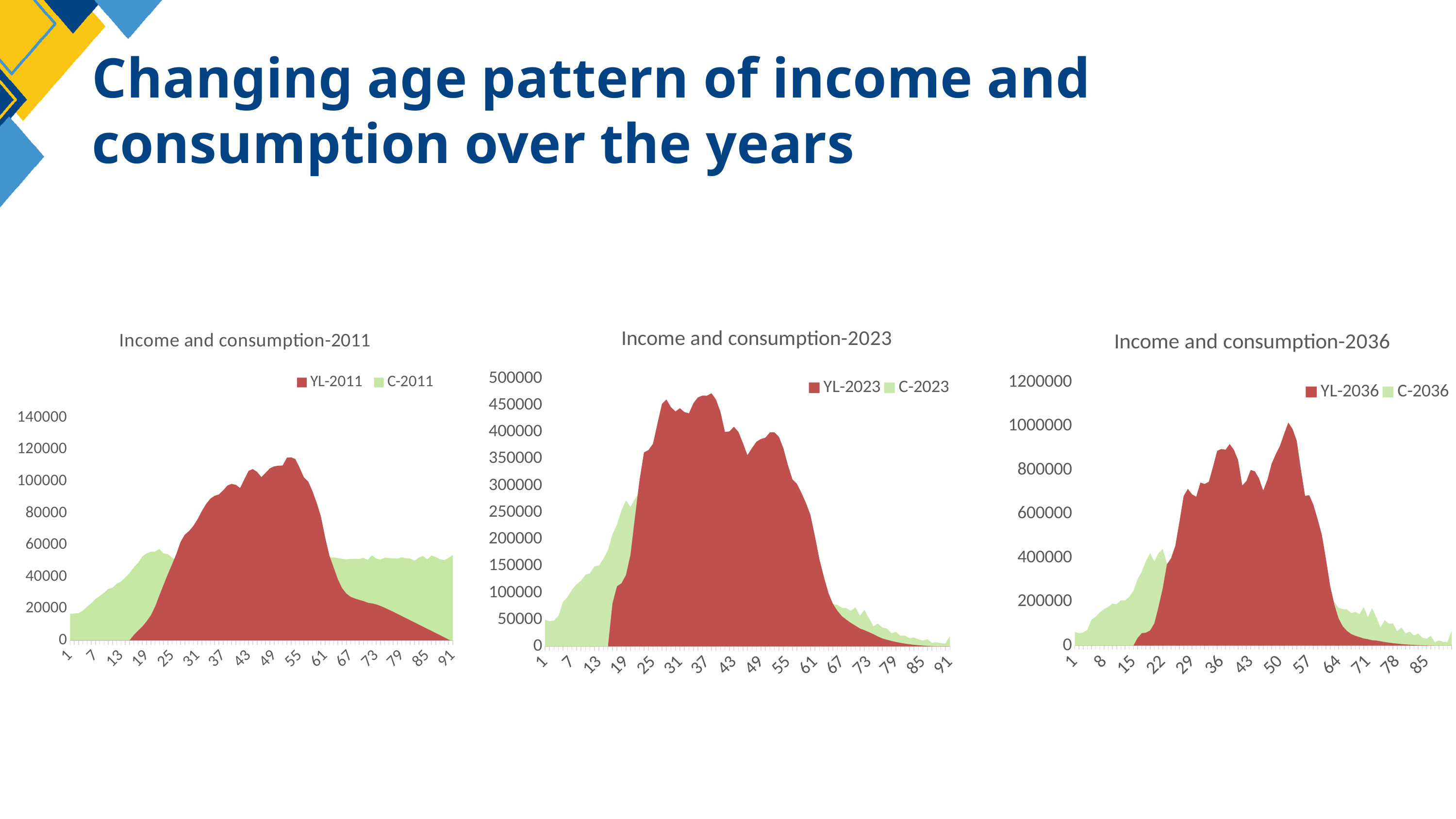
In 'Income and consumption-2036', what are the two series named in the legend? YL-2036 and C-2036 In 'Income and consumption-2036', is the peak value of YL-2036 around age 50 greater or less than 800000? greater How many charts are shown on the slide? 3 In 'Income and consumption-2011', at age 85, which series has the larger value, YL-2011 or C-2011? C-2011 How many series does the legend of 'Income and consumption-2023' list? 2 In 'Income and consumption-2011', is the value of YL-2011 at age 55 greater or less than 100000? greater In 'Income and consumption-2023', is the value of YL-2023 at age 37 greater or less than 400000? greater In 'Income and consumption-2011', which series is shown in red? YL-2011 What kind of chart is 'Income and consumption-2011'? Area chart In 'Income and consumption-2011', does the YL-2011 series rise or fall between age 61 and age 91? fall